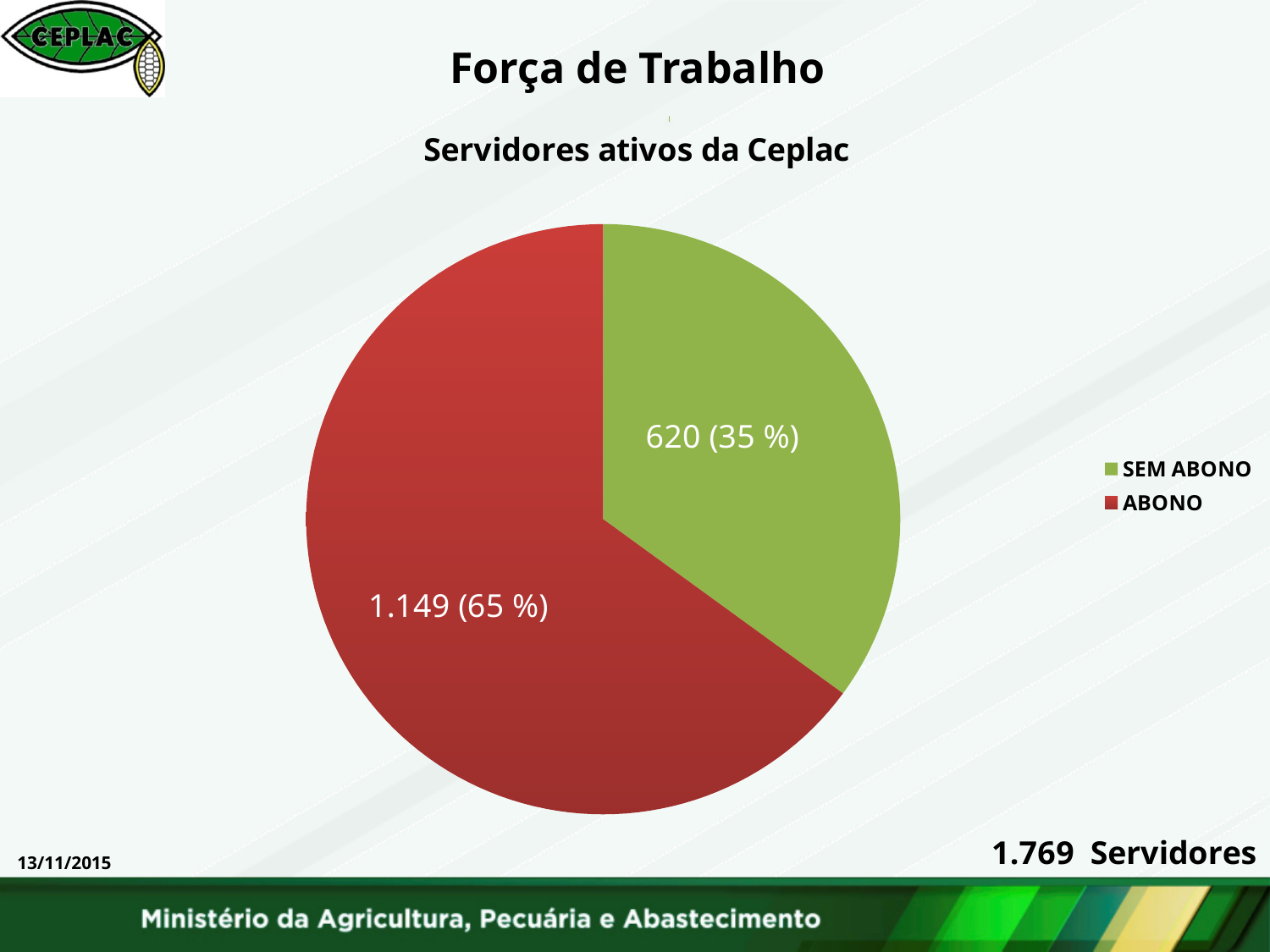
What is the title of the chart? Servidores ativos da Ceplac How many entries does the legend list? 2 What share of the pie does the ABONO slice represent? 65 % Which is larger, the ABONO slice or the SEM ABONO slice? ABONO Which slice is the largest? ABONO What is the value shown for the SEM ABONO slice? 620 (35 %) What kind of chart is shown on the slide? pie chart What share of the pie does the SEM ABONO slice represent? 35 % Which slice is the smallest? SEM ABONO How many slices does the pie chart have? 2 What is the value shown for the ABONO slice? 1.149 (65 %) What colour is the SEM ABONO slice? green